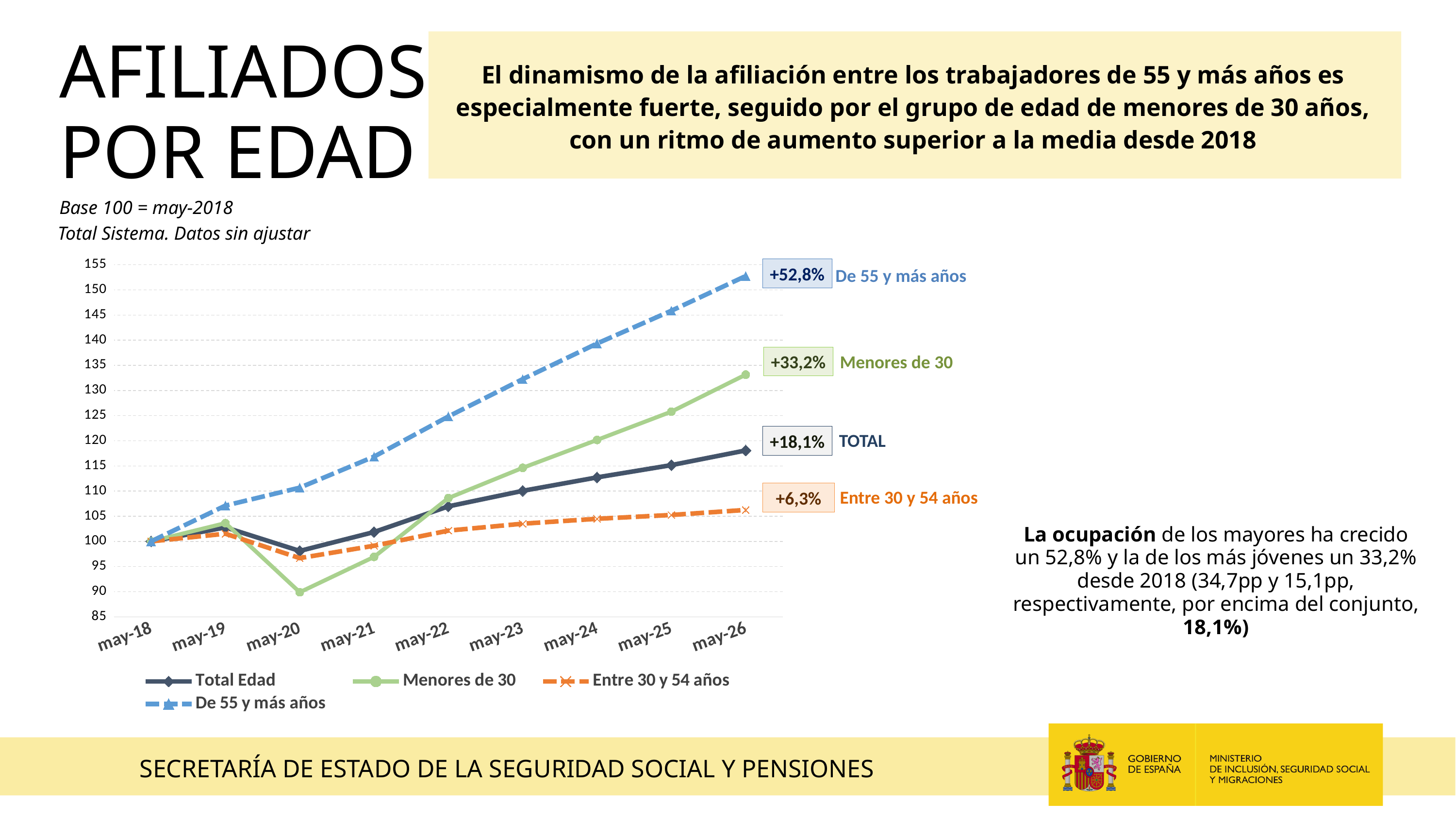
What growth percentage is labelled for the series 'Menores de 30'? +33,2% Which series shows the highest growth label at may-26? De 55 y más años What is the difference in percentage points between the growth labels of 'De 55 y más años' (+52,8%) and TOTAL (+18,1%)? 34,7pp How many points are there along the x axis of the chart? 9 What kind of chart is shown on the slide? line chart Is the value for 'De 55 y más años' at may-24 greater or less than 135? greater What growth percentage is labelled for the series 'De 55 y más años'? +52,8% How many series does the legend of the chart list? 4 What growth percentage is labelled for the TOTAL series? +18,1% Which series shows the lowest growth label at may-26? Entre 30 y 54 años Is the value for 'Menores de 30' at may-20 greater or less than 95? less What growth percentage is labelled for the series 'Entre 30 y 54 años'? +6,3%